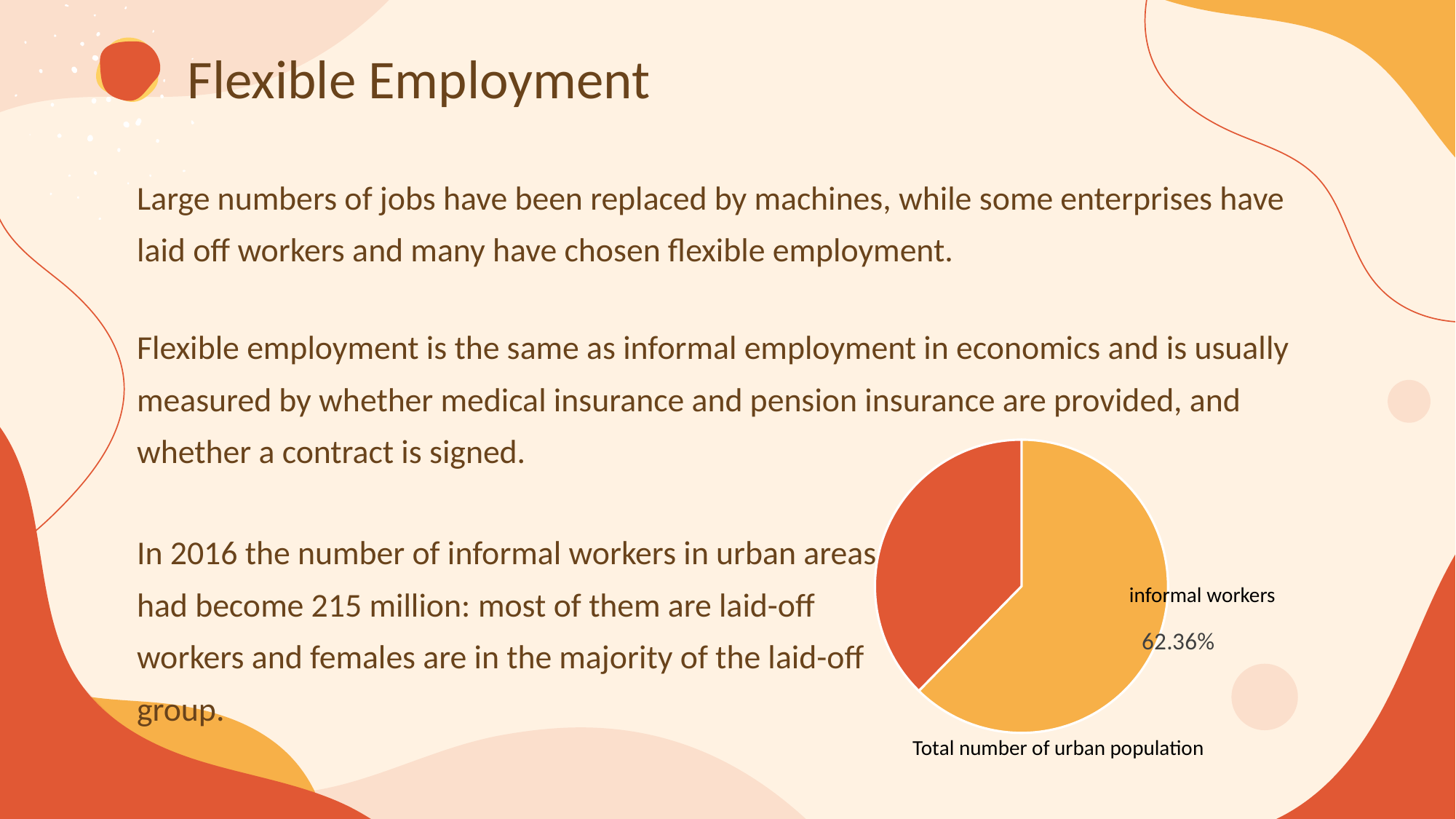
Which slice of the pie chart is the largest? informal workers How many slices does the pie chart have? 2 What kind of chart is shown on the slide? pie chart Is the share for informal workers greater or less than 50%? greater What share of the pie is labelled for informal workers? 62.36% Is the informal workers slice larger or smaller than the red slice? larger What label appears directly below the pie chart? Total number of urban population What percentage value is printed on the pie chart? 62.36% What colour is the informal workers slice of the pie chart? orange